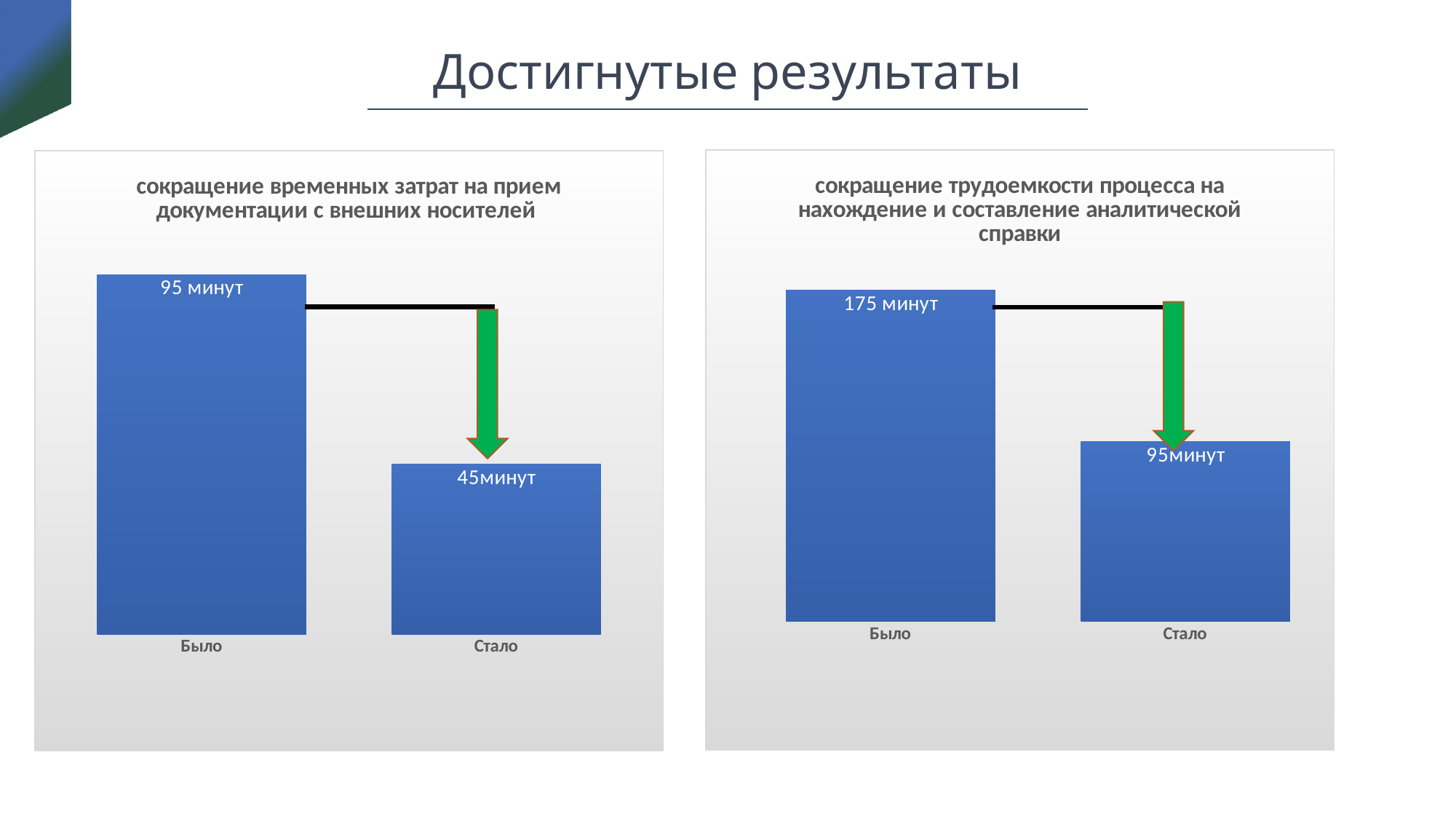
In the right chart, which category has the lowest value? Стало In the left chart, which category has the higher value, Было or Стало? Было In the right chart (сокращение трудоемкости процесса на нахождение и составление аналитической справки), what is the value for Стало? 95минут What is the title of the left chart? сокращение временных затрат на прием документации с внешних носителей In the left chart (сокращение временных затрат на прием документации с внешних носителей), what is the value for Стало? 45минут In the left chart, by how many minutes did the value decrease from Было to Стало? 50 минут In the left chart (сокращение временных затрат на прием документации с внешних носителей), what is the value for Было? 95 минут In the right chart, what is the difference between Было and Стало? 80 минут How many categories does the left chart show? 2 In the right chart, do the values rise or fall from Было to Стало? Fall In the right chart (сокращение трудоемкости процесса на нахождение и составление аналитической справки), what is the value for Было? 175 минут What kind of chart is the right chart? Bar chart